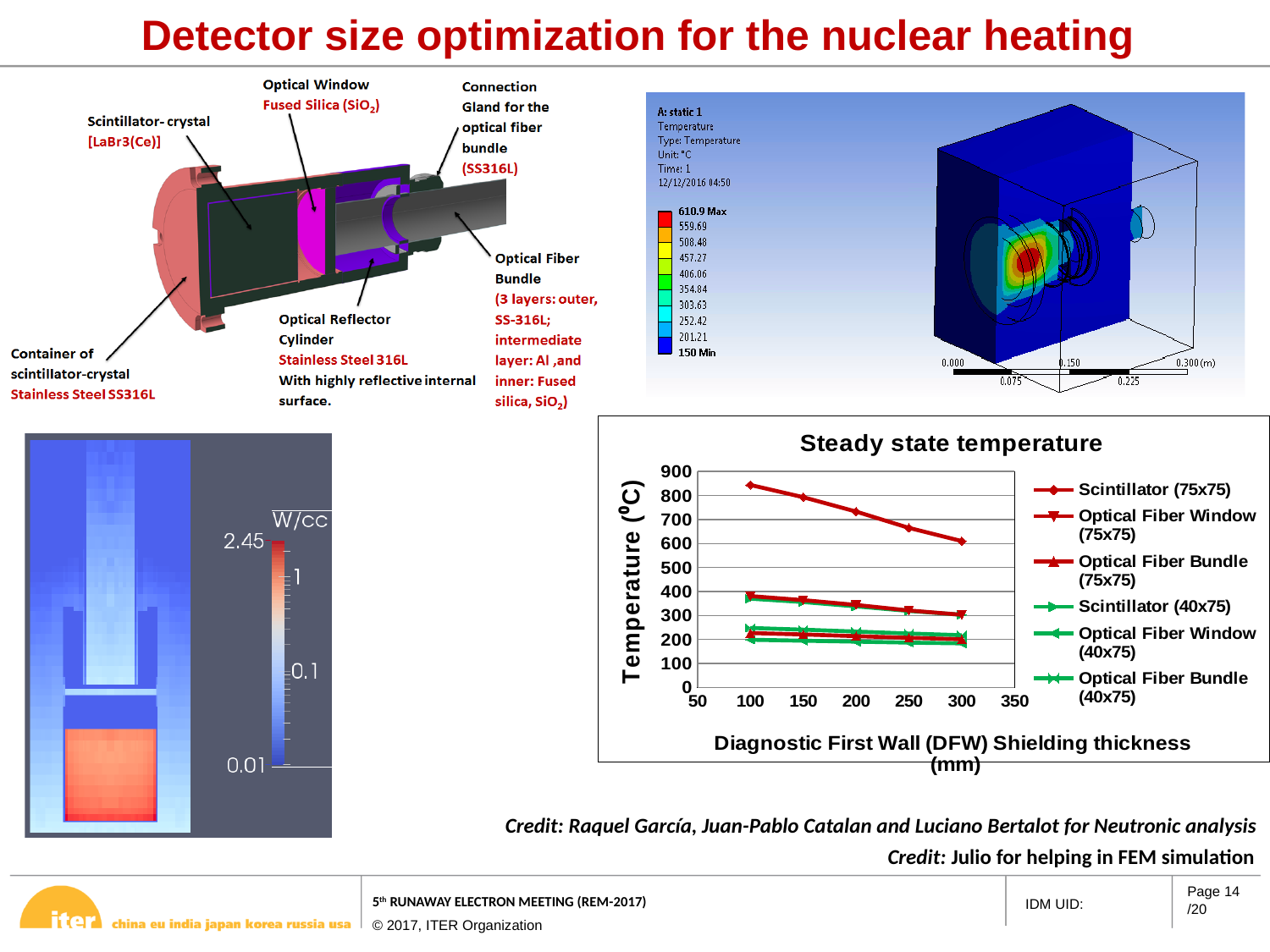
In the "Steady state temperature" chart, which series has the highest temperature at every shielding thickness? Scintillator (75x75) What is the x-axis label of the "Steady state temperature" chart? Diagnostic First Wall (DFW) Shielding thickness (mm) In the "Steady state temperature" chart, is the temperature of the Scintillator (75x75) at 100 mm greater or less than 800? greater What kind of chart is the "Steady state temperature" chart? line chart In the "Steady state temperature" chart, is the temperature of the Scintillator (40x75) at 100 mm greater or less than 200? greater In the "Steady state temperature" chart, which is larger at 200 mm: the temperature of the Scintillator (75x75) or the Scintillator (40x75)? Scintillator (75x75) In the "Steady state temperature" chart, does the temperature of the Scintillator (75x75) rise or fall as the DFW shielding thickness increases? fall How many series does the legend of the "Steady state temperature" chart list? 6 How many shielding thickness data points are plotted for each series in the "Steady state temperature" chart? 5 In the "Steady state temperature" chart, is the temperature of the Scintillator (75x75) at 300 mm greater or less than 700? less What is the title of the chart on the slide? Steady state temperature